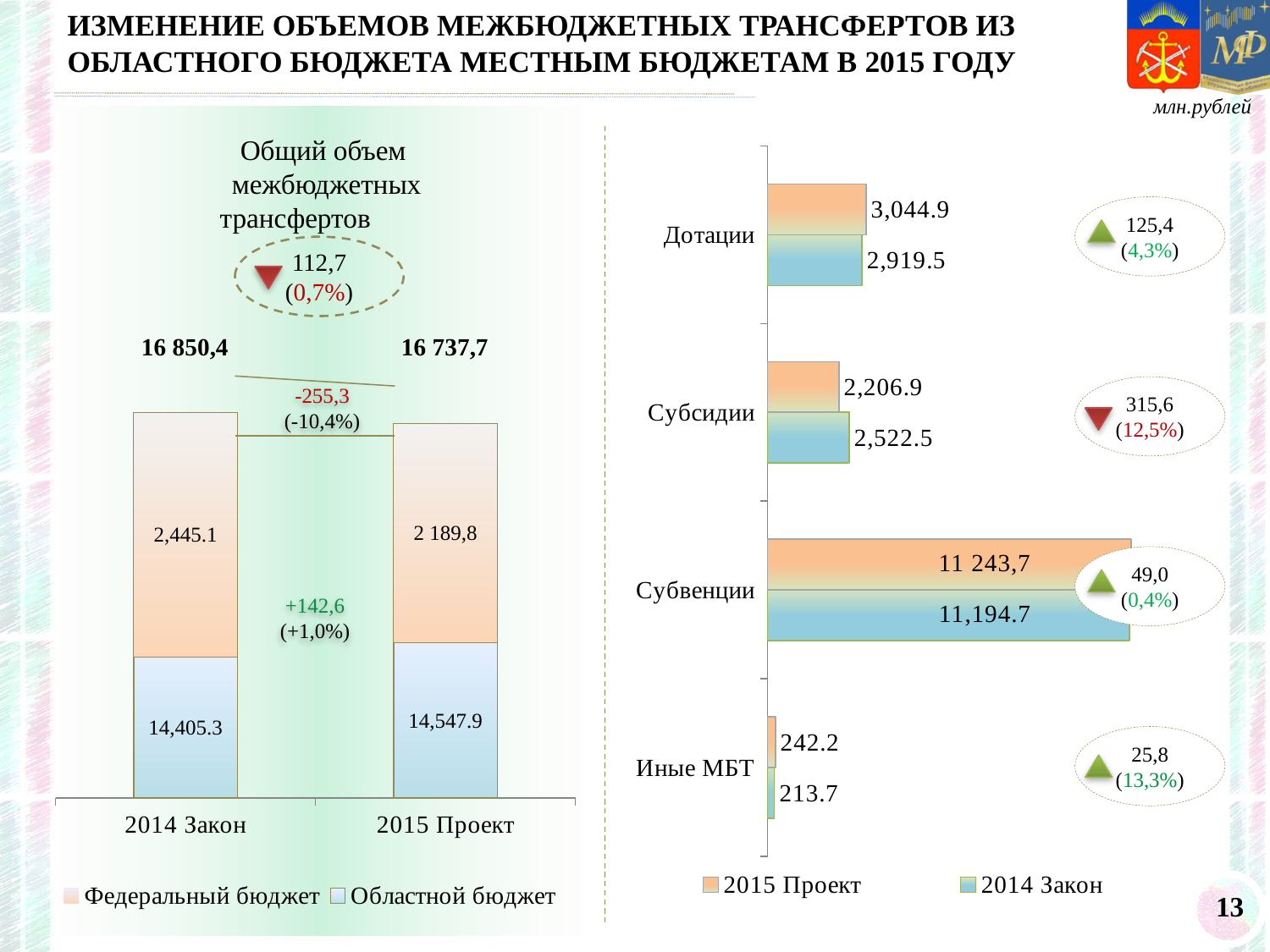
What kind of chart is the left chart? Stacked bar chart In the left chart, what is the total of the stacked bar for 2015 Проект? 16 737,7 In the right chart, for Дотации, which is larger: 2015 Проект or 2014 Закон? 2015 Проект In the right chart, what is the value of Иные МБТ for 2015 Проект? 242.2 In the right chart, what is the value of Субсидии for 2014 Закон? 2,522.5 In the right chart, which category has the lowest value for 2014 Закон? Иные МБТ In the left chart, what is the value of Областной бюджет for 2014 Закон? 14,405.3 How many categories are shown in the right chart? 4 In the right chart, which category has the highest value for 2015 Проект? Субвенции How many series does the legend of the left chart list? 2 In the right chart, what is the difference between the 2014 Закон and 2015 Проект values for Субсидии? 315.6 In the left chart, what is the value of Федеральный бюджет for 2015 Проект? 2 189,8